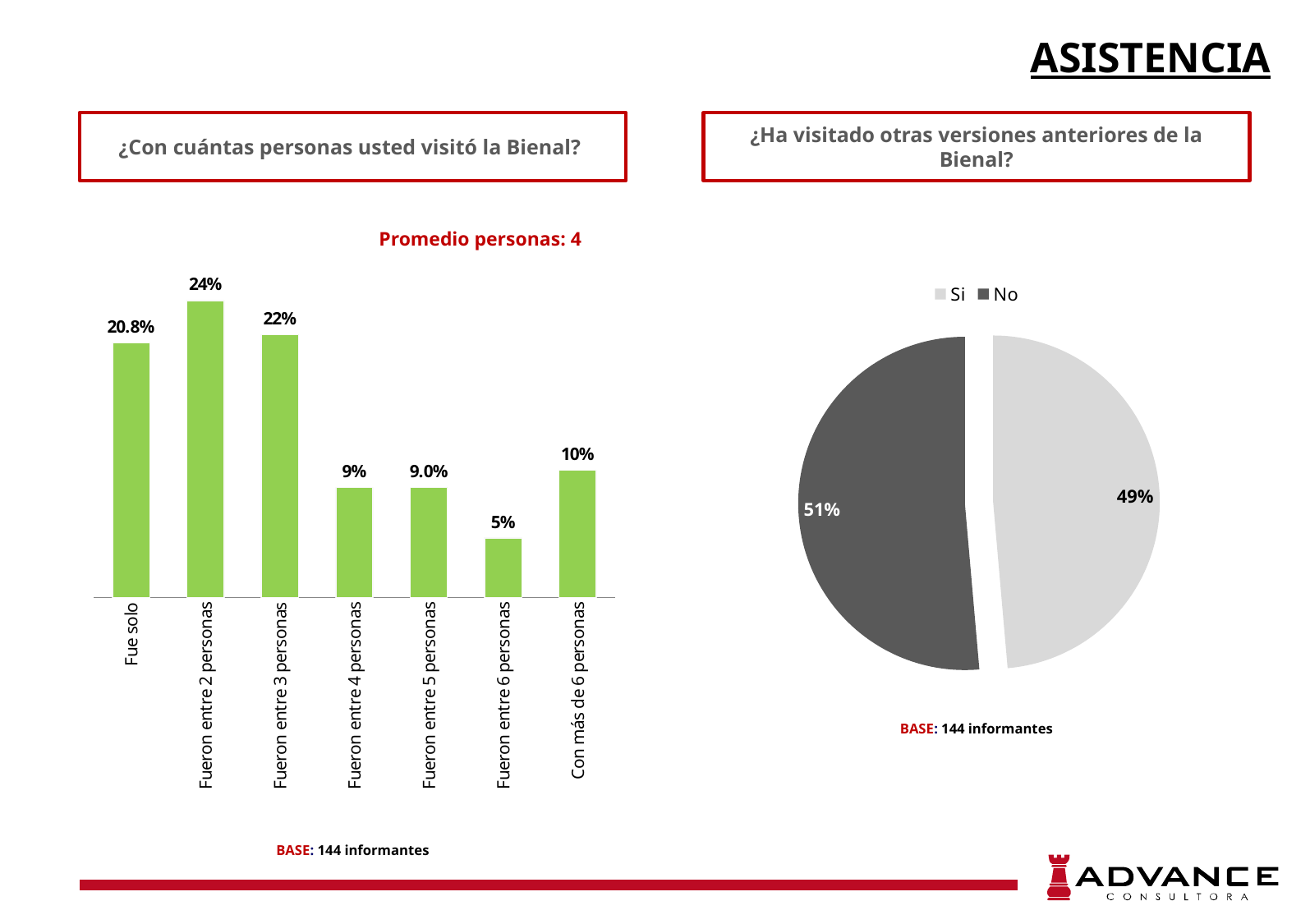
What is the 'Promedio personas' value shown above the bar chart on the left? 4 In the bar chart '¿Con cuántas personas usted visitó la Bienal?', which is larger: 'Con más de 6 personas' or 'Fueron entre 6 personas'? Con más de 6 personas In the bar chart '¿Con cuántas personas usted visitó la Bienal?', what is the difference between 'Fueron entre 2 personas' and 'Fueron entre 3 personas'? 2% In the bar chart '¿Con cuántas personas usted visitó la Bienal?', which category has the lowest value? Fueron entre 6 personas In the pie chart '¿Ha visitado otras versiones anteriores de la Bienal?', what share is 'No'? 51% How many entries does the legend of the pie chart '¿Ha visitado otras versiones anteriores de la Bienal?' list? 2 In the bar chart '¿Con cuántas personas usted visitó la Bienal?', what is the value for 'Fueron entre 6 personas'? 5% How many categories does the bar chart '¿Con cuántas personas usted visitó la Bienal?' show? 7 In the bar chart '¿Con cuántas personas usted visitó la Bienal?', which category has the highest value? Fueron entre 2 personas What type of chart is used for '¿Con cuántas personas usted visitó la Bienal?'? Bar chart In the pie chart '¿Ha visitado otras versiones anteriores de la Bienal?', what is the value for 'Si'? 49% In the bar chart '¿Con cuántas personas usted visitó la Bienal?', what is the value for 'Fue solo'? 20.8%